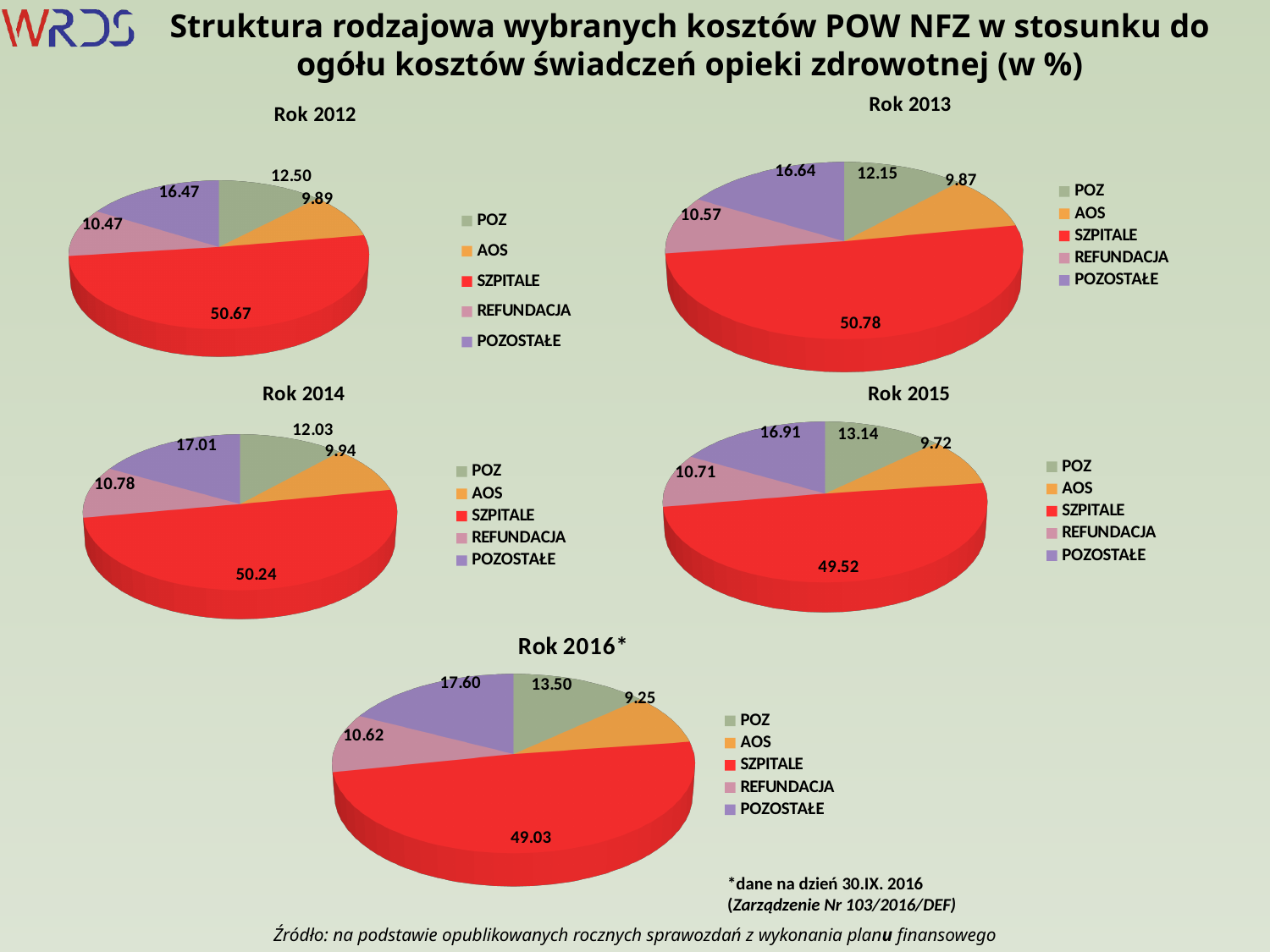
In the Rok 2012 chart, which category has the smallest slice? AOS What kind of chart is the Rok 2012 chart? Pie chart In the Rok 2015 chart, what is the difference between the values for POZOSTAŁE and POZ? 3.77 In the Rok 2012 chart, what is the value for SZPITALE? 50.67 How many categories does the Rok 2014 chart show? 5 In the Rok 2014 chart, what is the value for REFUNDACJA? 10.78 In the Rok 2016* chart, what is the value for POZ? 13.50 How many pie charts are shown on the slide? 5 In the Rok 2016* chart, which category has the largest slice? SZPITALE In the Rok 2015 chart, what is the value for AOS? 9.72 In the Rok 2013 chart, which is larger, the value for POZ or the value for REFUNDACJA? POZ In the Rok 2013 chart, what is the value for POZOSTAŁE? 16.64